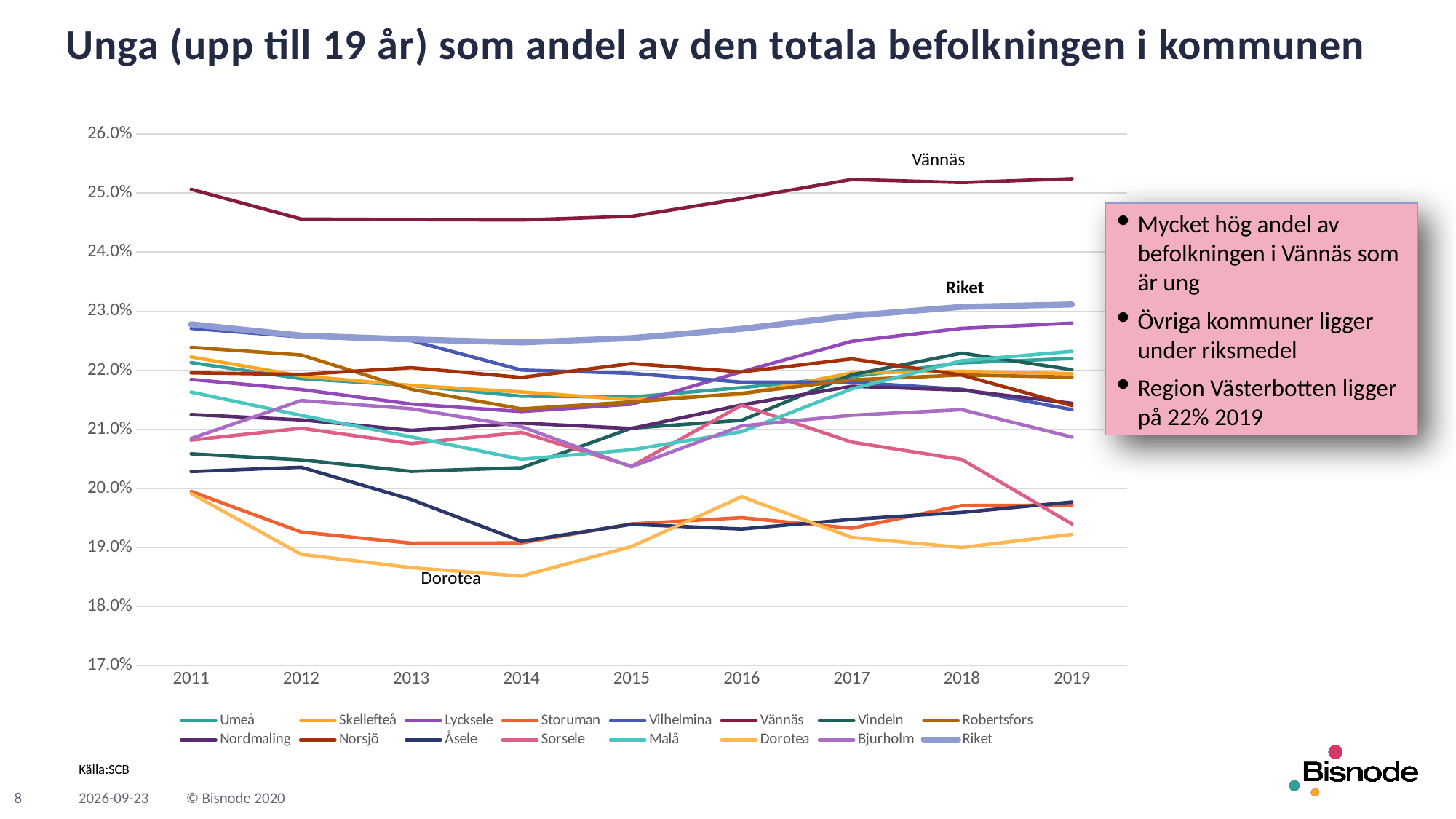
Is the value for Vännäs in 2019 greater or less than 25.0%? greater Does the value for Dorotea rise or fall from 2014 to 2019? rise Which series has the lowest value in 2014? Dorotea Is the value for Dorotea in 2014 greater or less than 19.0%? less Is the value for Sorsele in 2019 greater or less than 20.0%? less Which is larger in 2019, the value for Vännäs or the value for Riket? Vännäs What kind of chart is shown on the slide? Line chart How many series does the legend list? 16 Which series has the highest values across all years? Vännäs How many years are shown along the x axis? 9 What is the title of the chart? Unga (upp till 19 år) som andel av den totala befolkningen i kommunen